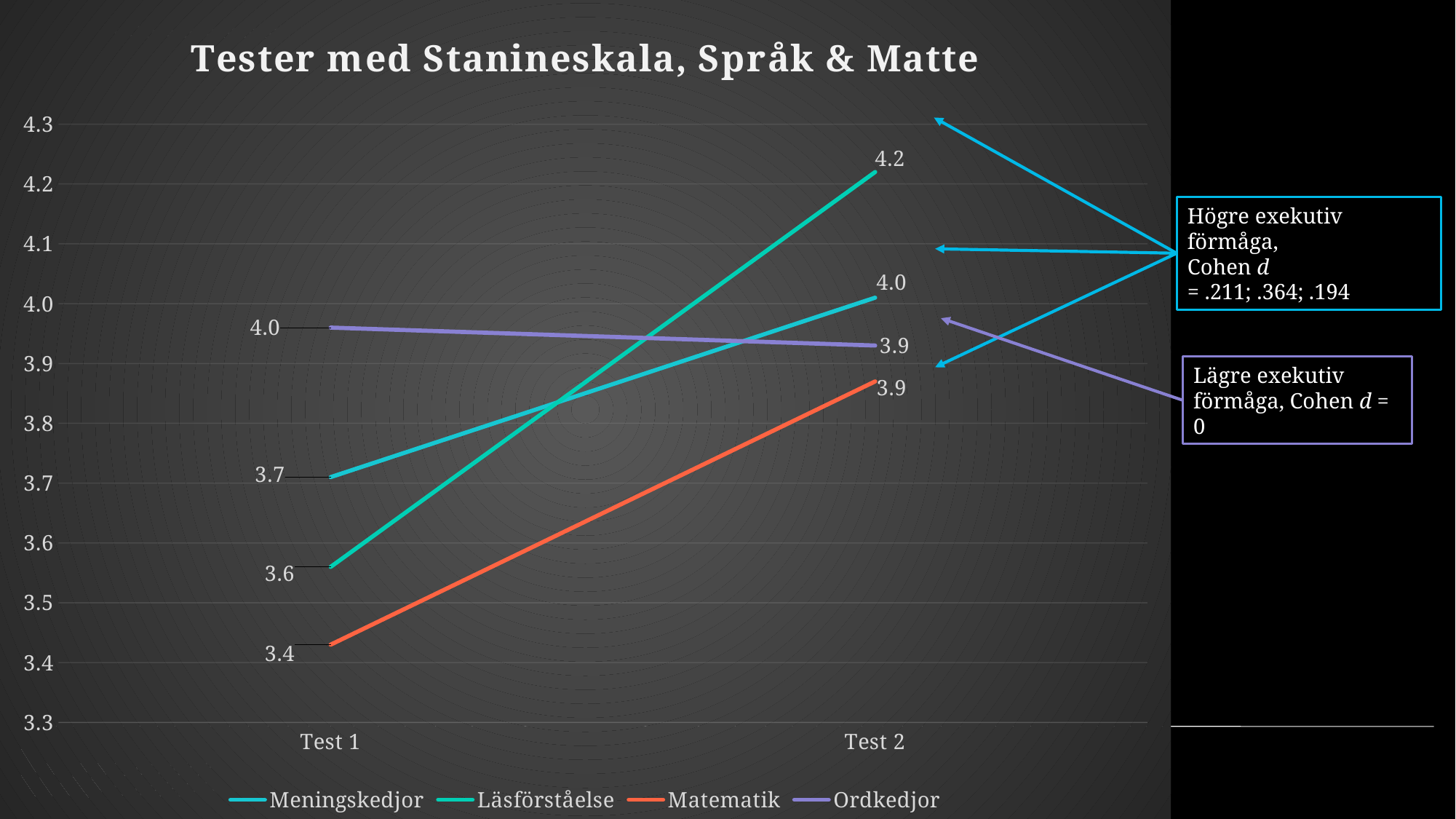
How many series does the legend list? 4 What is the value for Matematik at Test 1? 3.4 Does the Ordkedjor series rise or fall from Test 1 to Test 2? fall What type of chart is shown on the slide? line chart What is the value for Läsförståelse at Test 2? 4.2 What is the value for Meningskedjor at Test 2? 4.0 What is the title of the chart? Tester med Stanineskala, Språk & Matte Which series has the lowest value at Test 1? Matematik What is the value for Ordkedjor at Test 1? 4.0 How many points are on the x axis? 2 Which series has the highest value at Test 2? Läsförståelse What is the difference between the Läsförståelse values at Test 2 and Test 1? 0.6